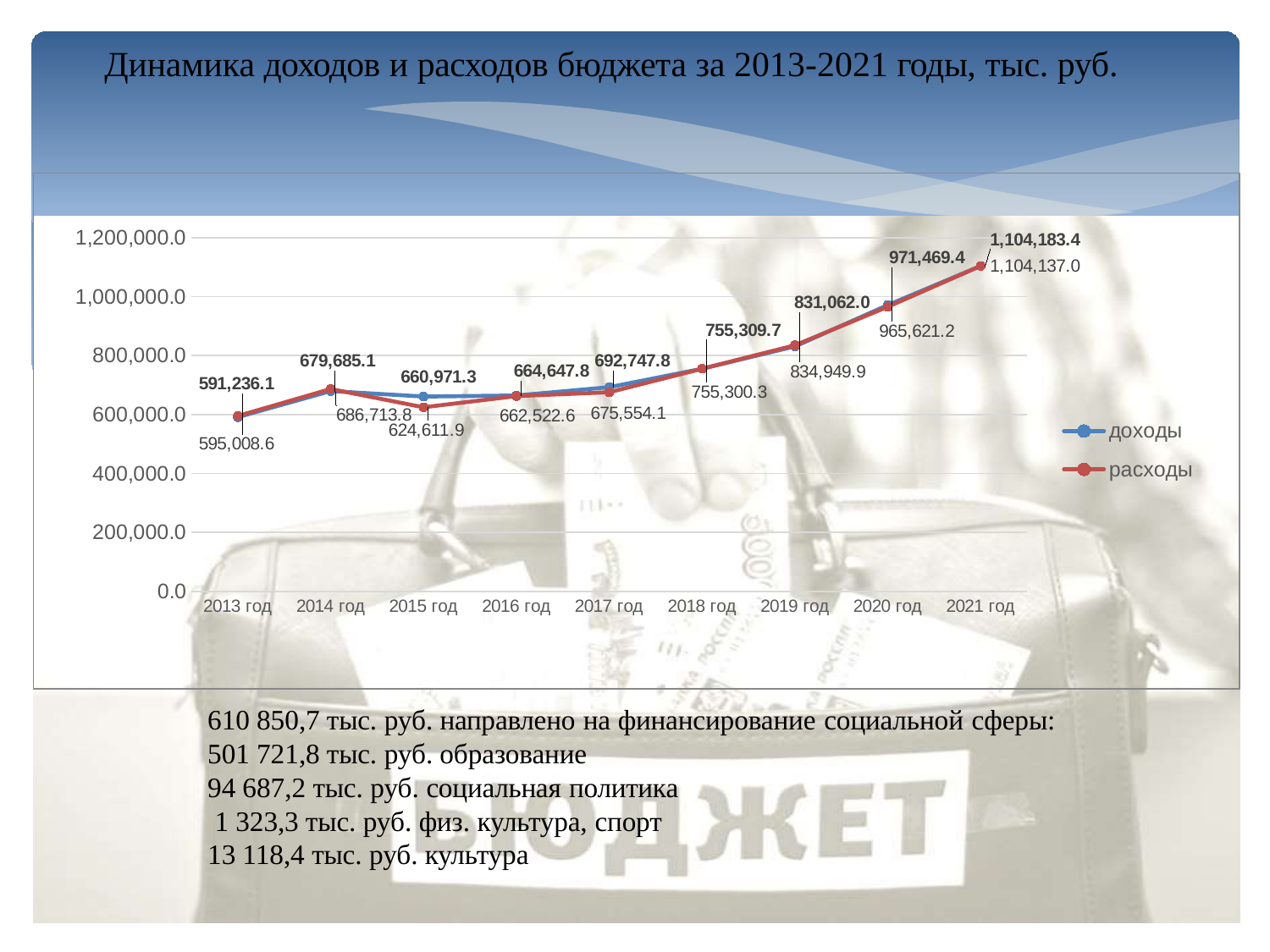
In which year is расходы lowest? 2013 год What is the value of расходы for 2021 год? 1,104,137.0 What is the value of доходы for 2020 год? 971,469.4 What is the value of расходы for 2015 год? 624,611.9 How many years are shown on the x axis? 9 How many series does the legend list? 2 Do the values of расходы rise or fall overall from 2013 год to 2021 год? rise In which year is доходы highest? 2021 год What kind of chart is shown on the slide? line chart What is the value of доходы for 2013 год? 591,236.1 What is the difference between доходы and расходы in 2015 год? 36,359.4 Which is larger in 2014 год, доходы or расходы? расходы